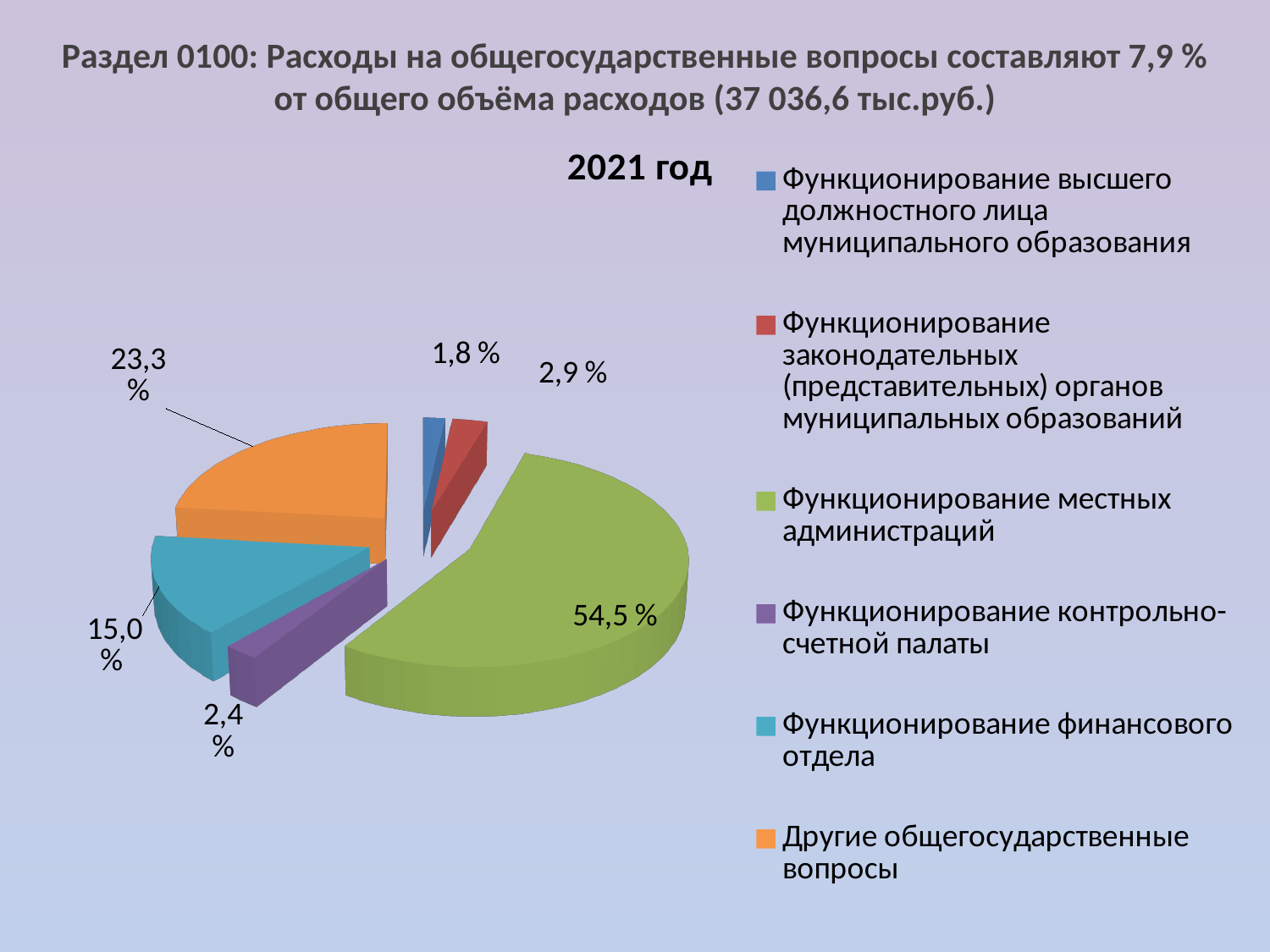
What share of the pie is 'Функционирование местных администраций'? 54,5 % What kind of chart is shown on the slide? Pie chart What is the value shown for 'Функционирование финансового отдела'? 15,0 % What is the value shown for 'Другие общегосударственные вопросы'? 23,3 % Which category has the smallest share of the pie? Функционирование высшего должностного лица муниципального образования How many slices does the pie chart have? 6 How many entries does the legend list? 6 What is the difference between the shares of 'Другие общегосударственные вопросы' and 'Функционирование финансового отдела'? 8,3 % What is the value shown for 'Функционирование высшего должностного лица муниципального образования'? 1,8 % What is the value shown for 'Функционирование контрольно-счетной палаты'? 2,4 % Which category has the largest share of the pie? Функционирование местных администраций What is the chart's title? 2021 год